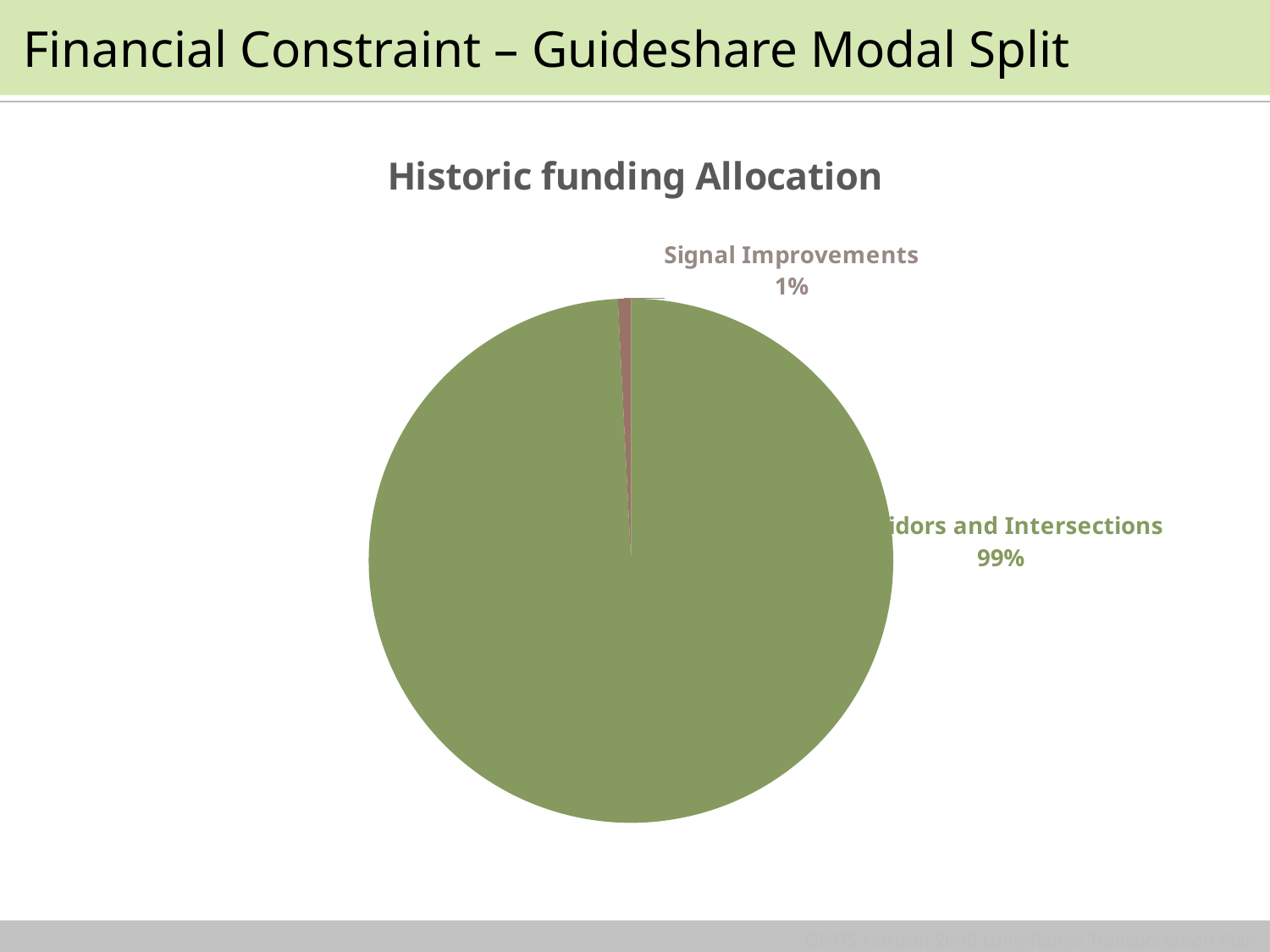
Which is larger: the Signal Improvements slice or the '...idors and Intersections' slice? ...idors and Intersections What colour is the largest slice of the pie? green What is the title of the chart? Historic funding Allocation What kind of chart is shown on the slide? pie chart What share of the pie does Signal Improvements have? 1% Is the share for Signal Improvements greater or less than 50%? less What share of the pie does the slice labelled '...idors and Intersections' have? 99% Which slice is the smallest in the pie chart? Signal Improvements By how many percentage points does the '...idors and Intersections' share exceed the Signal Improvements share? 98 percentage points How many slices does the pie chart have? 2